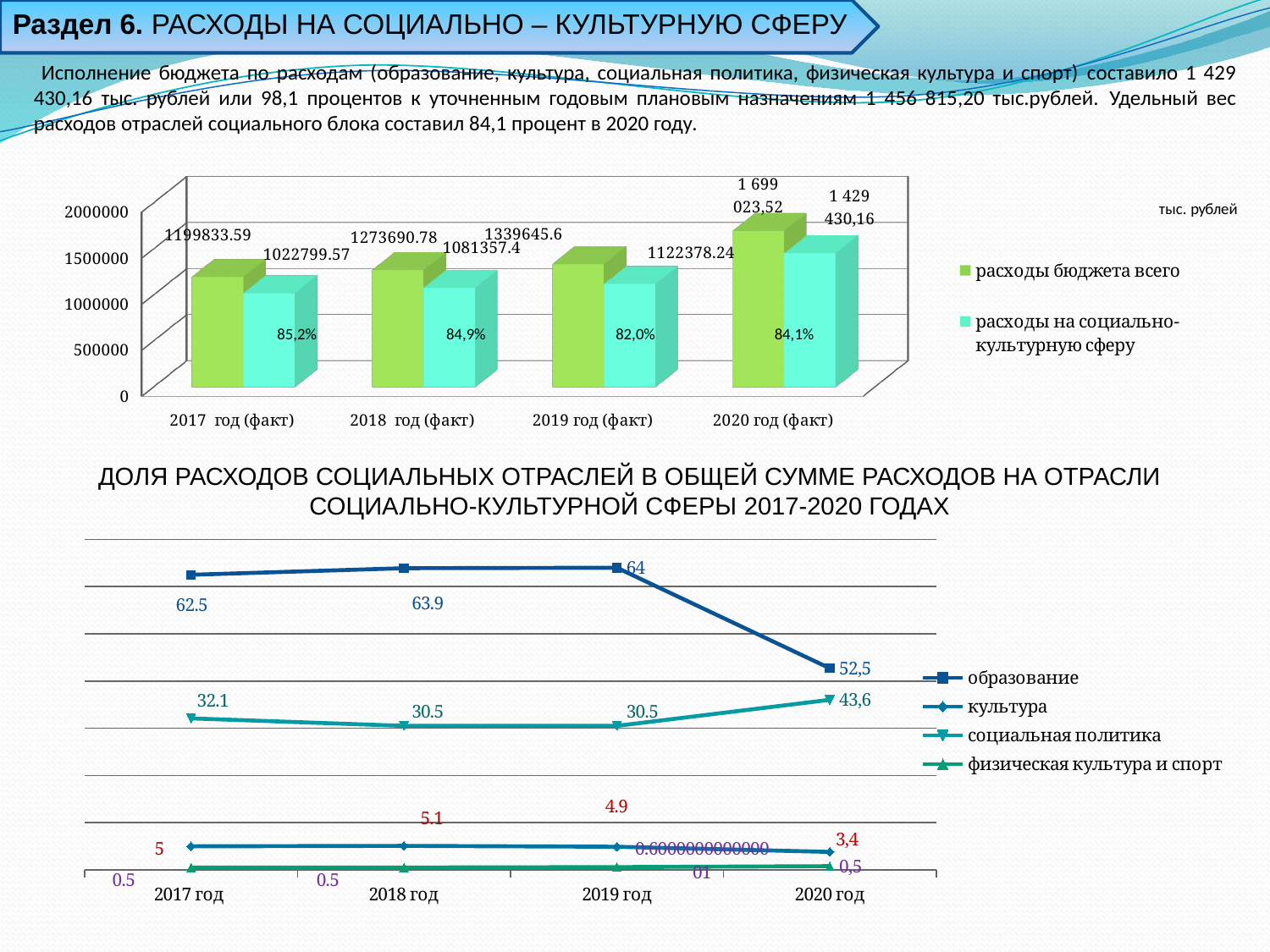
On the top bar chart, is the value of расходы на социально-культурную сферу for 2017 год (факт) greater or less than 1000000? greater What kind of chart is the top chart on the slide? bar chart On the bottom line chart, does the value for образование rise or fall from 2019 год to 2020 год? fall On the bottom line chart (ДОЛЯ РАСХОДОВ СОЦИАЛЬНЫХ ОТРАСЛЕЙ...), what is the value for образование in 2018 год? 63.9 On the top bar chart, how many series does the legend list? 2 On the top bar chart, which year has the highest value for расходы бюджета всего? 2020 год (факт) On the bottom line chart, how many series does the legend list? 4 On the top bar chart, what is the value of расходы бюджета всего for 2017 год (факт)? 1199833.59 On the top bar chart, what is the value of расходы на социально-культурную сферу for 2019 год (факт)? 1122378.24 On the bottom line chart, which series has the lowest value in 2017 год? физическая культура и спорт On the bottom line chart, what is the value for социальная политика in 2020 год? 43,6 On the top bar chart, what percentage label is shown for 2018 год (факт)? 84,9%